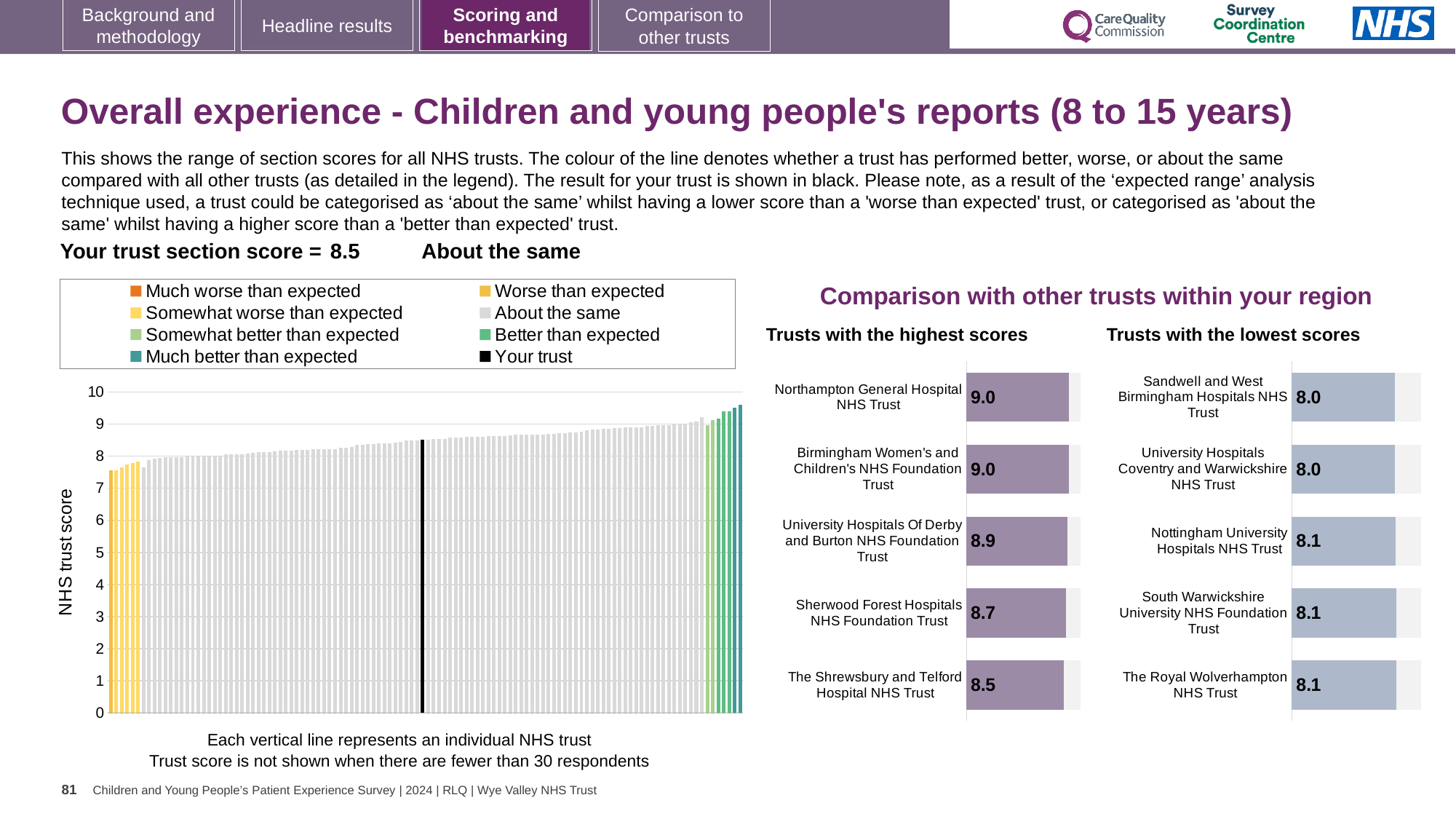
On the 'Trusts with the highest scores' chart, what is the score for Northampton General Hospital NHS Trust? 9.0 On the 'Trusts with the lowest scores' chart, what is the score for Nottingham University Hospitals NHS Trust? 8.1 On the 'Trusts with the highest scores' chart, what is the score for Sherwood Forest Hospitals NHS Foundation Trust? 8.7 What kind of chart is the main chart showing the range of NHS trust scores? Bar chart How many trusts are shown on the 'Trusts with the lowest scores' chart? 5 On the main chart of NHS trust scores, do the values rise or fall from left to right? Rise On the 'Trusts with the highest scores' chart, which trust has the lowest score? The Shrewsbury and Telford Hospital NHS Trust On the 'Trusts with the highest scores' chart, which has the higher score: University Hospitals Of Derby and Burton NHS Foundation Trust or Sherwood Forest Hospitals NHS Foundation Trust? University Hospitals Of Derby and Burton NHS Foundation Trust On the 'Trusts with the highest scores' chart, what is the difference between the scores of Northampton General Hospital NHS Trust and The Shrewsbury and Telford Hospital NHS Trust? 0.5 On the main chart of NHS trust scores, what is your trust's section score? 8.5 What is the title of the section containing the highest and lowest scores charts on the right of the slide? Comparison with other trusts within your region How many entries does the legend of the main NHS trust score chart list? 8